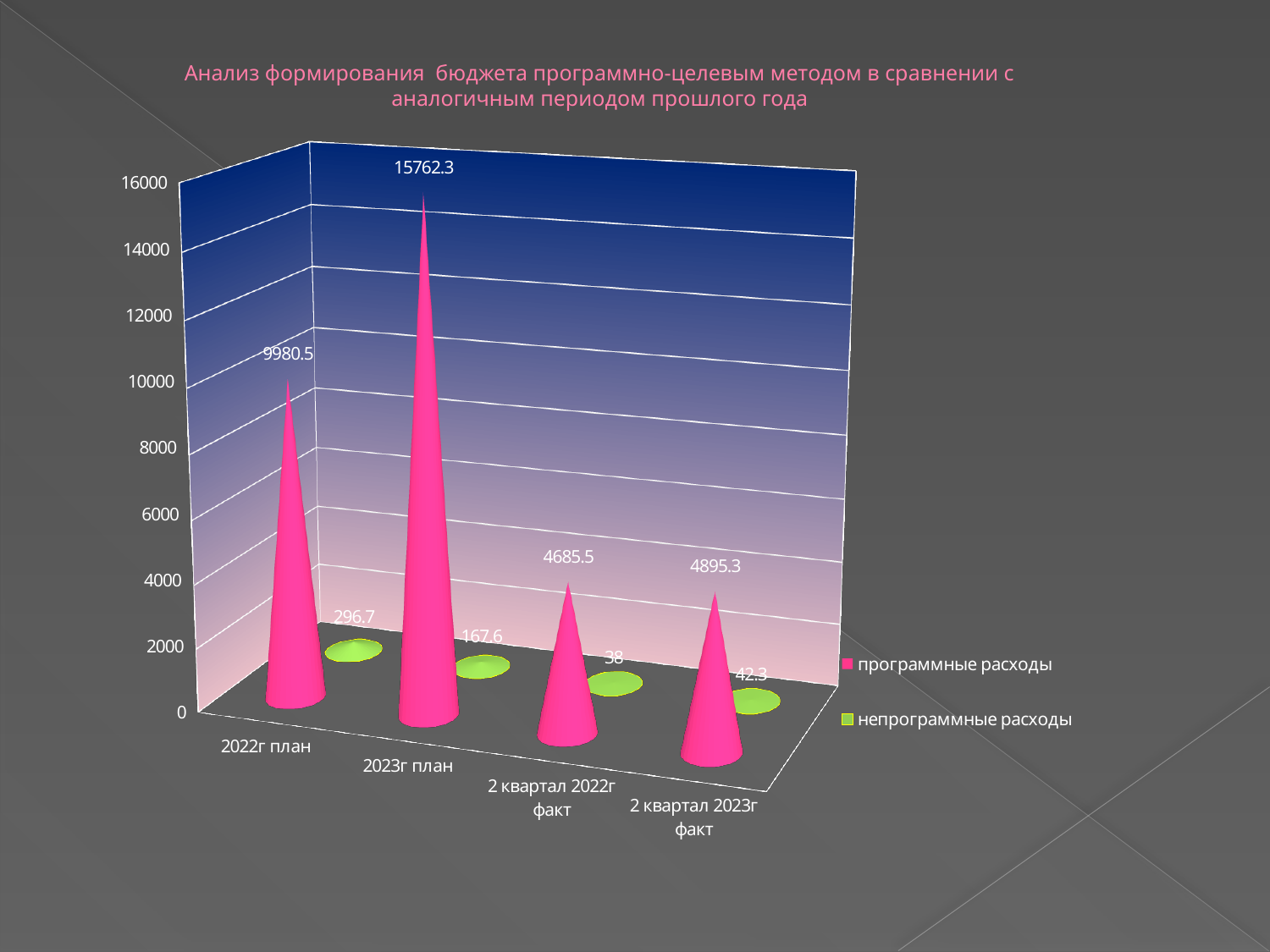
What is the value of программные расходы for 2023г план? 15762.3 What kind of chart is shown on the slide? bar chart Which category has the lowest value for непрограммные расходы? 2 квартал 2022г факт What colour represents непрограммные расходы in the legend? green How many series does the legend list? 2 Which is larger: программные расходы for 2 квартал 2022г факт or for 2 квартал 2023г факт? 2 квартал 2023г факт Which category has the highest value for программные расходы? 2023г план What is the value of непрограммные расходы for 2 квартал 2022г факт? 38 How many categories are shown on the x axis? 4 What is the value of программные расходы for 2 квартал 2023г факт? 4895.3 What is the value of непрограммные расходы for 2022г план? 296.7 What is the difference between программные расходы for 2023г план and 2022г план? 5781.8